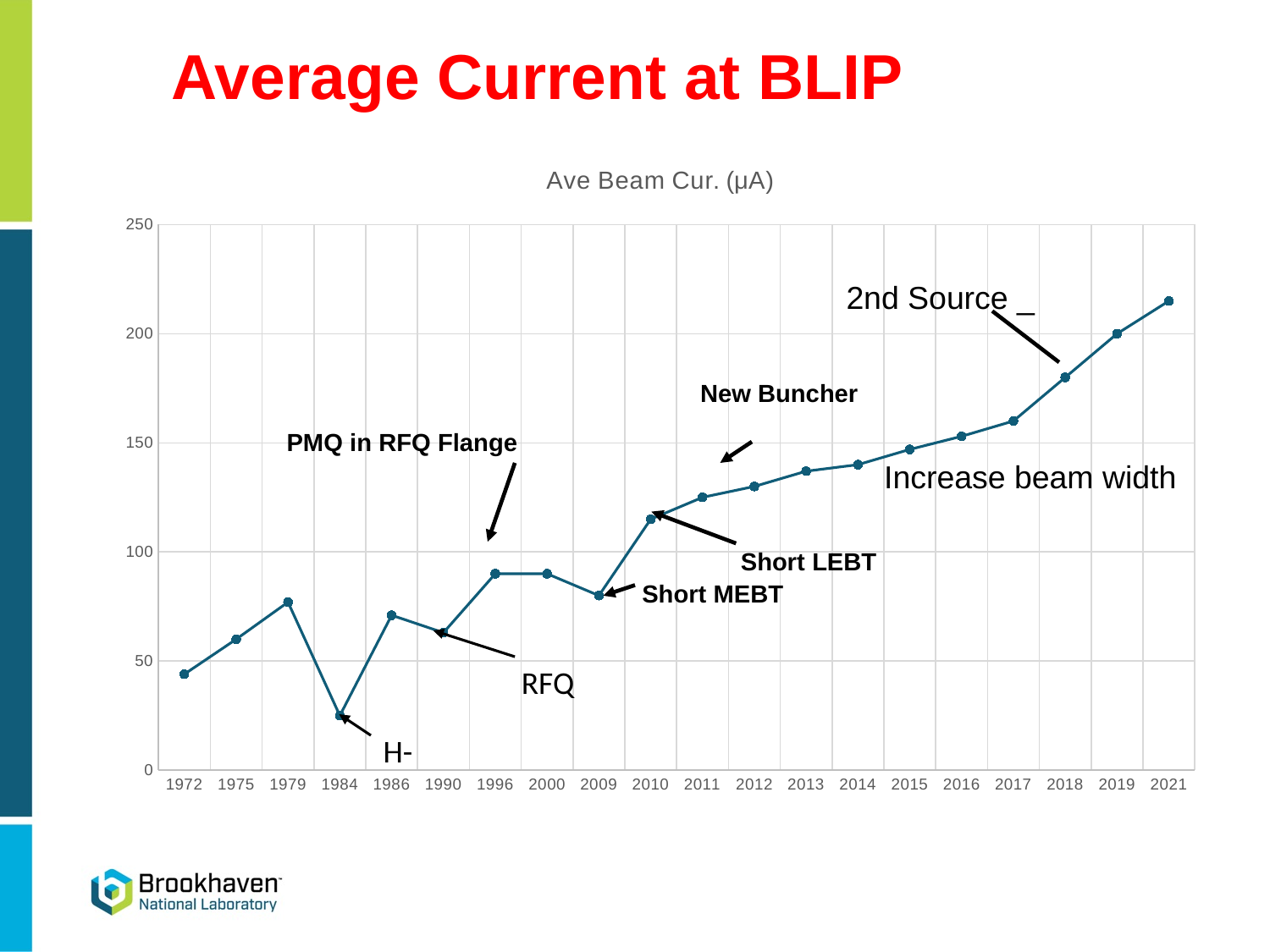
What is the average beam current for 2019? 200 What is the title of the chart? Ave Beam Cur. (μA) Which year has the lowest average beam current? 1984 Is the value for 1984 greater or less than 50? less Do the values rise or fall from 2009 to 2021? rise Is the value for 2010 greater or less than 100? greater What kind of chart is shown on the slide? line chart Which year has the highest average beam current? 2021 Is the value for 2009 greater or less than 100? less How many data points are plotted along the x axis? 20 Which year has the larger value, 1979 or 1984? 1979